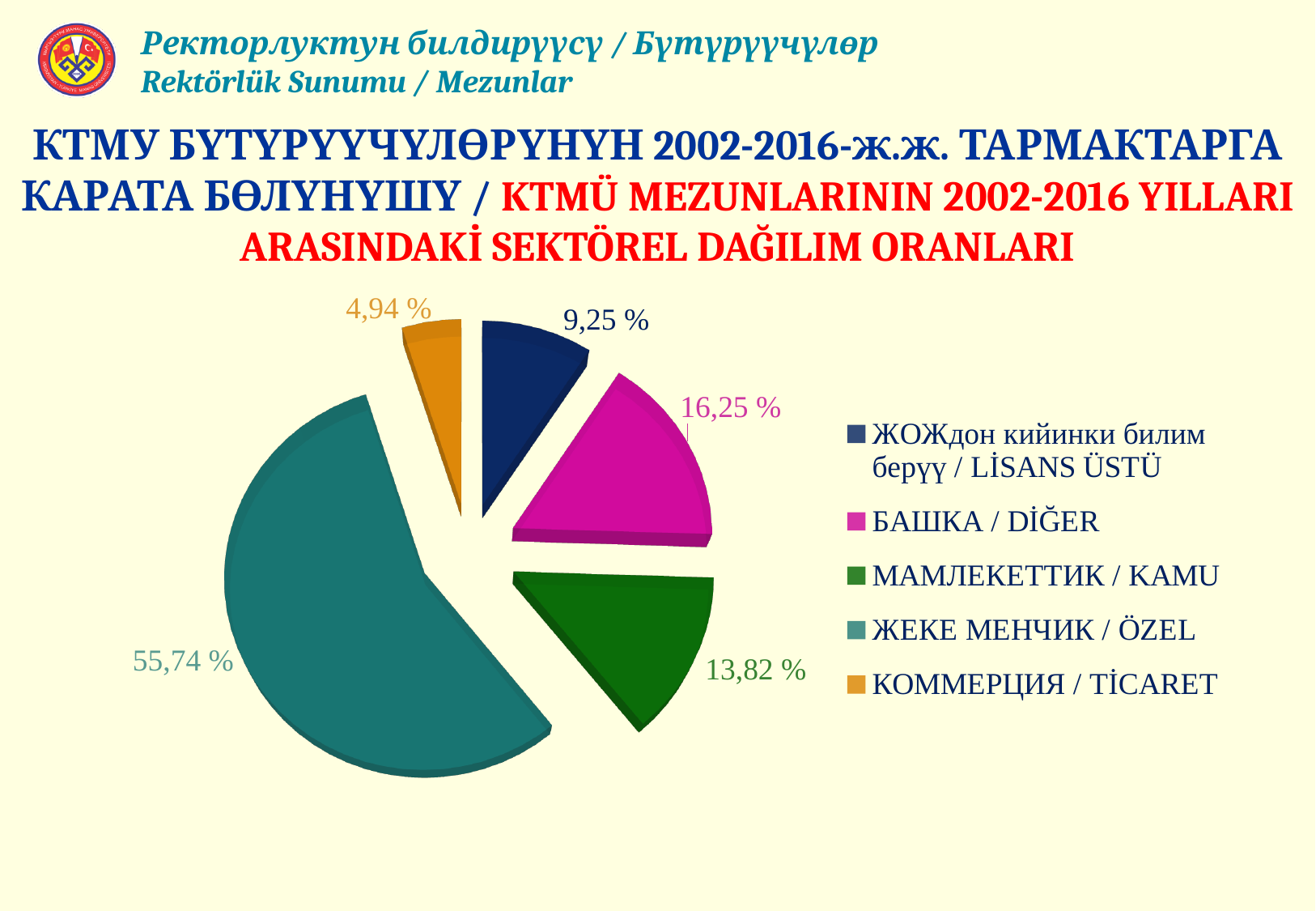
Which category has the smallest slice of the pie? КОММЕРЦИЯ / TİCARET What is the value shown for ЖОЖдон кийинки билим берүү / LİSANS ÜSTÜ? 9,25 % What is the value shown for МАМЛЕКЕТТИК / КАМU? 13,82 % What colour is the slice for ЖЕКЕ МЕНЧИК / ÖZEL? teal Which is larger, the slice for БАШКА / DİĞER or the slice for МАМЛЕКЕТТИК / КАМU? БАШКА / DİĞER What is the value shown for БАШКА / DİĞER? 16,25 % What is the difference between the values for ЖЕКЕ МЕНЧИК / ÖZEL and БАШКА / DİĞER? 39,49 % What share of the pie does ЖЕКЕ МЕНЧИК / ÖZEL have? 55,74 % Which category has the largest slice of the pie? ЖЕКЕ МЕНЧИК / ÖZEL How many categories does the legend of the pie chart list? 5 What is the value shown for КОММЕРЦИЯ / TİCARET? 4,94 % What kind of chart is shown on the slide? pie chart